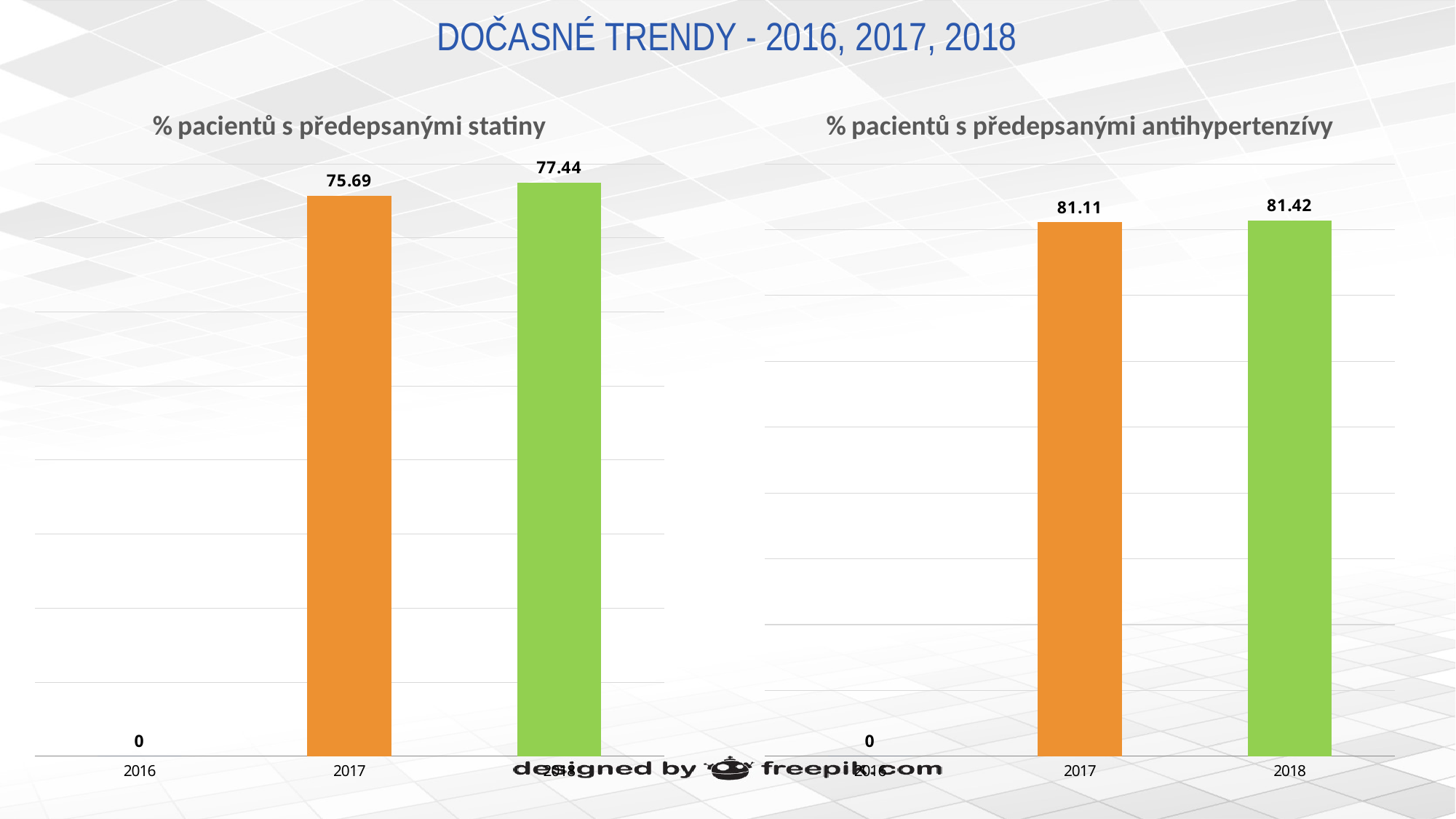
How many categories are shown on the x axis of the chart titled "% pacientů s předepsanými statiny"? 3 What kind of chart is the chart on the right side of the slide? Bar chart In the chart titled "% pacientů s předepsanými statiny", what is the value for 2016? 0 In the chart titled "% pacientů s předepsanými statiny", which year has the highest value? 2018 In the chart titled "% pacientů s předepsanými antihypertenzívy", what is the value for 2017? 81.11 In the chart titled "% pacientů s předepsanými statiny", what is the value for 2018? 77.44 In the chart titled "% pacientů s předepsanými statiny", what is the value for 2017? 75.69 In the chart titled "% pacientů s předepsanými antihypertenzívy", what is the value for 2018? 81.42 In the chart titled "% pacientů s předepsanými antihypertenzívy", which year has the lowest value? 2016 In the chart titled "% pacientů s předepsanými antihypertenzívy", which is larger, the value for 2017 or for 2018? 2018 In the chart titled "% pacientů s předepsanými antihypertenzívy", what is the difference between the 2018 and 2017 values? 0.31 In the chart titled "% pacientů s předepsanými statiny", what is the difference between the 2018 and 2017 values? 1.75